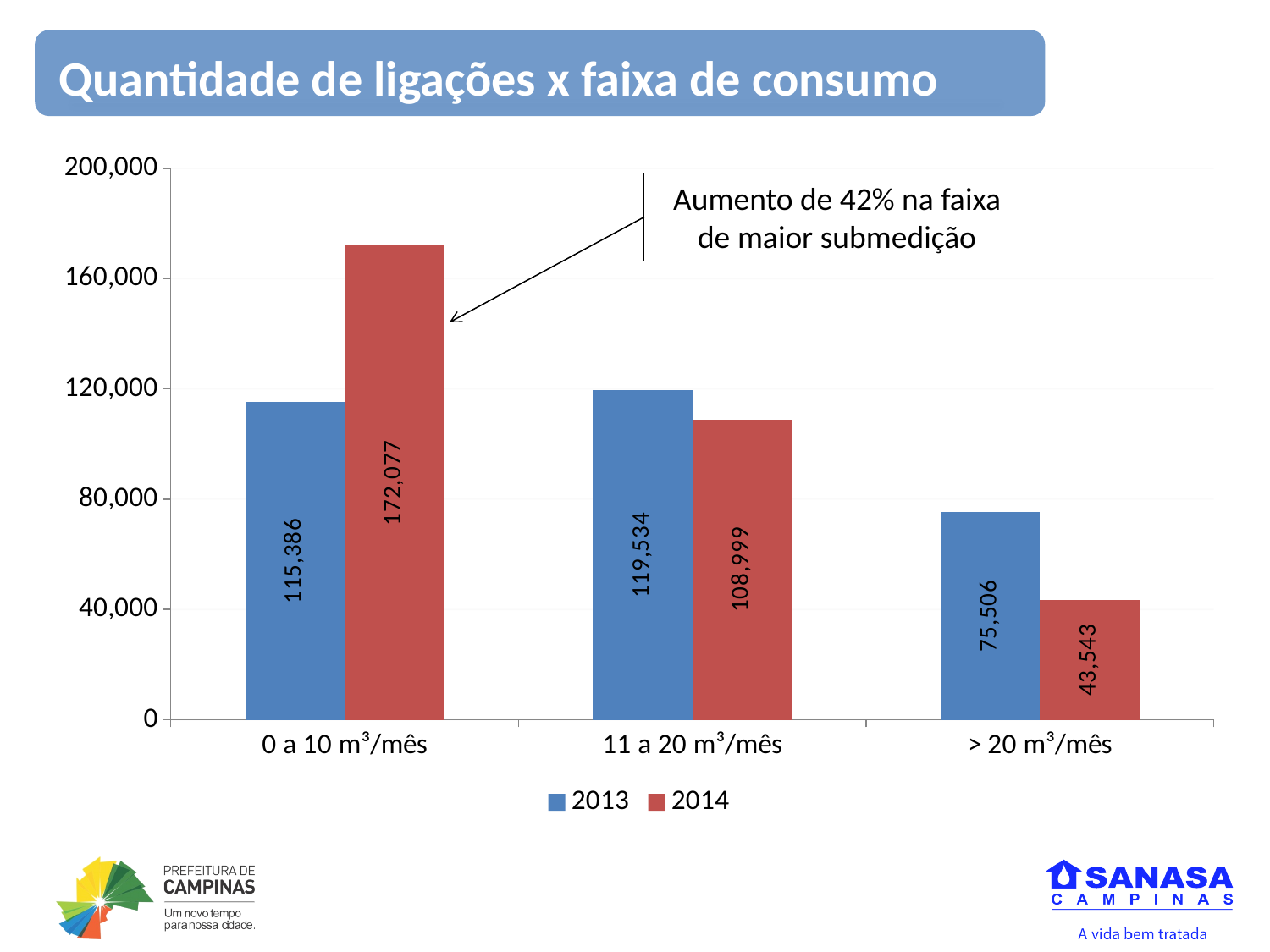
What is the value for 2014 in the "> 20 m³/mês" category? 43,543 What is the difference between the 2013 and 2014 values in the "> 20 m³/mês" category? 31,963 What kind of chart is shown on the slide? Bar chart What is the difference between the 2014 and 2013 values in the "0 a 10 m³/mês" category? 56,691 What is the title of the chart on the slide? Quantidade de ligações x faixa de consumo Which category has the highest value for the 2014 series? 0 a 10 m³/mês What is the value for 2014 in the "0 a 10 m³/mês" category? 172,077 In the "11 a 20 m³/mês" category, which series has the larger value, 2013 or 2014? 2013 How many consumption categories are shown on the x axis? 3 What is the value for 2013 in the "11 a 20 m³/mês" category? 119,534 How many series does the legend list? 2 Which category has the lowest value for the 2013 series? > 20 m³/mês